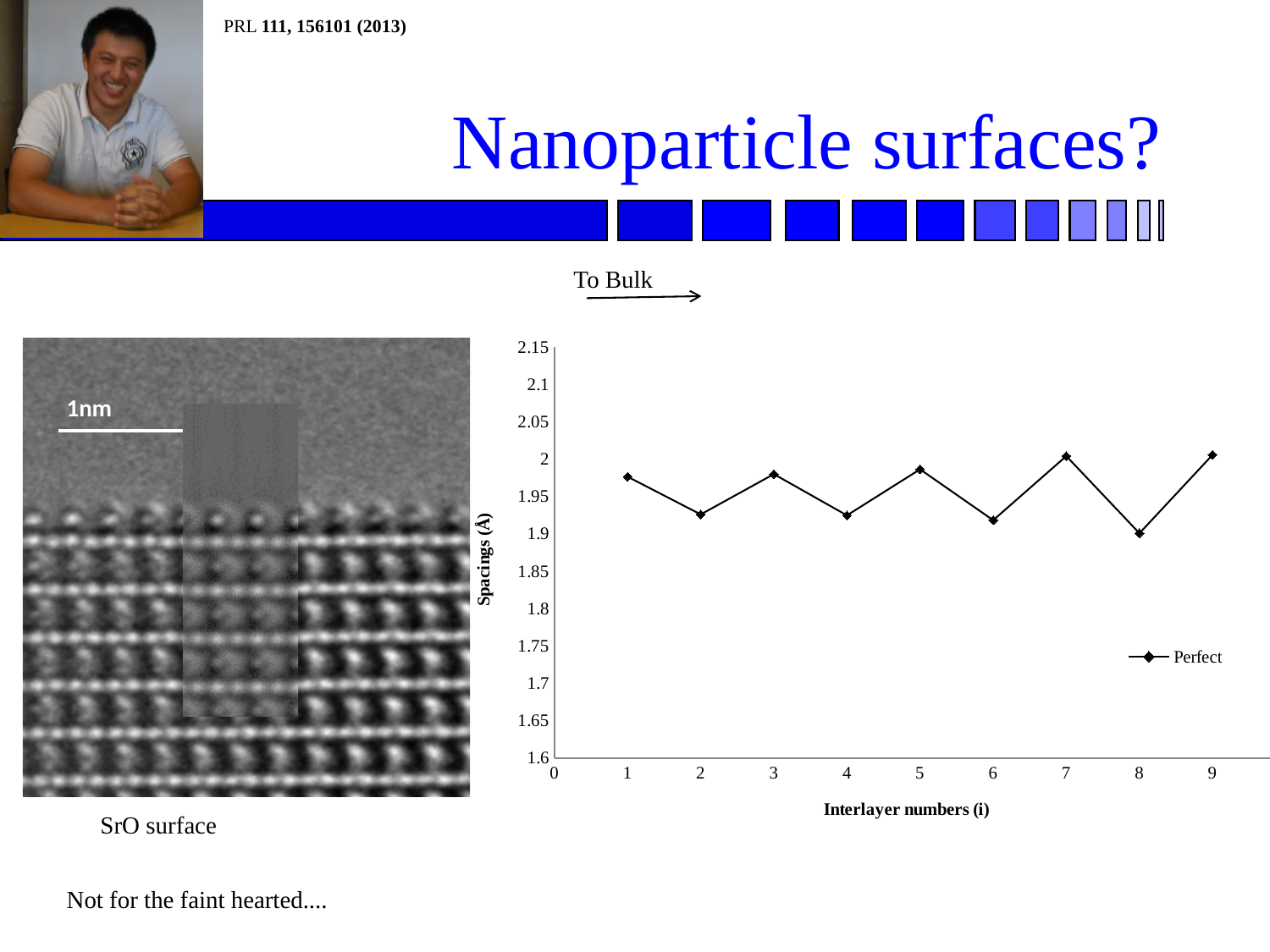
Which has the larger spacing value, interlayer number 7 or interlayer number 8? 7 Is the spacing value for interlayer number 6 greater or less than 1.95? less Is the spacing value for interlayer number 7 greater or less than 1.95? greater Do the spacing values for the odd interlayer numbers (1, 3, 5, 7, 9) rise or fall as the interlayer number increases? rise What is the name of the series shown in the legend of the line chart? Perfect What is the title of the x axis of the line chart? Interlayer numbers (i) How many series does the legend of the line chart list? 1 How many data points are plotted on the line chart? 9 Is the spacing value for interlayer number 1 greater or less than 1.9? greater Which interlayer number has the lowest spacing value? 8 What kind of chart is shown on the slide? line chart